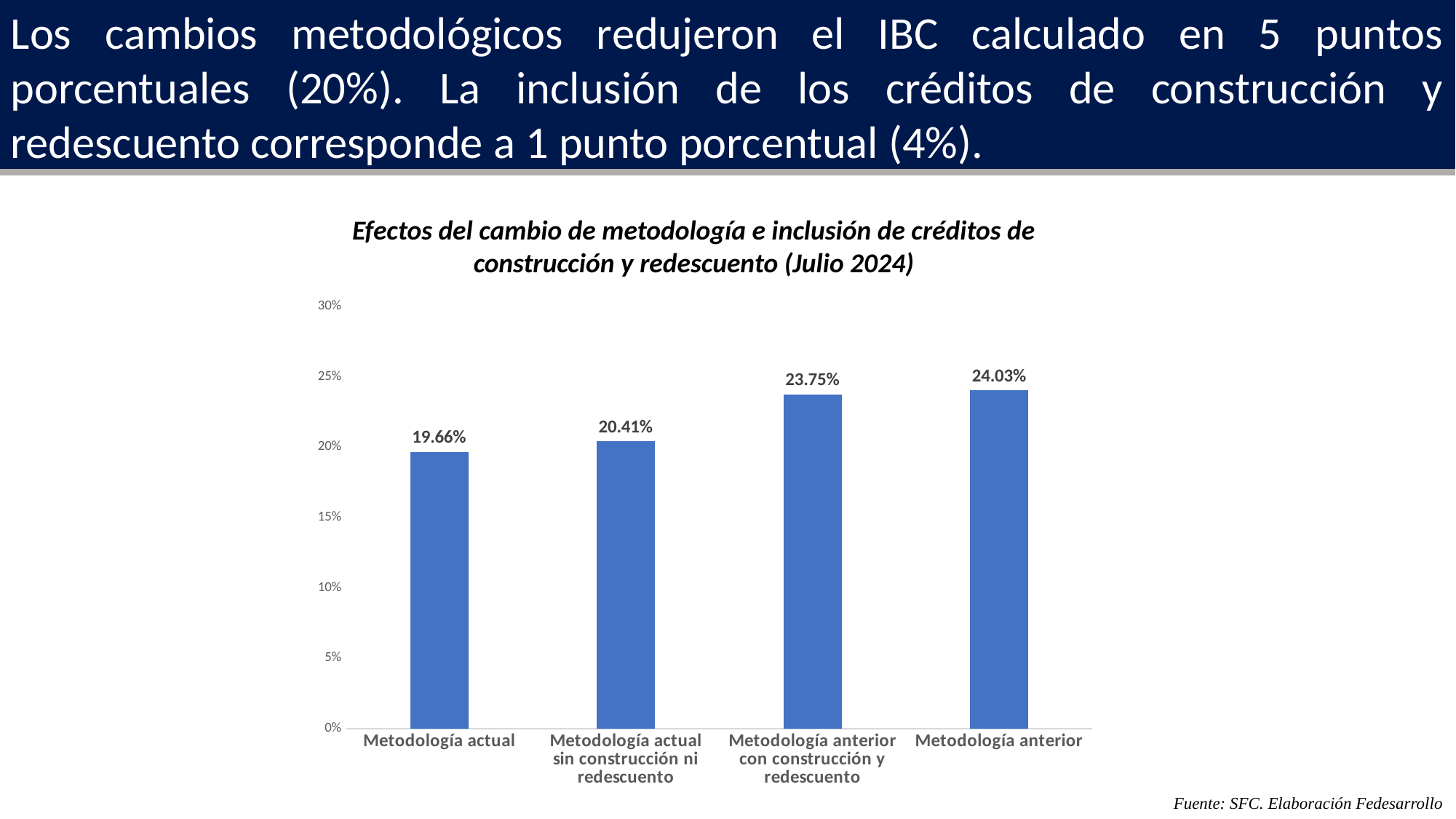
What is the difference between Metodología anterior and Metodología actual? 4.37% How many categories are shown in the chart? 4 What is the value for Metodología anterior? 24.03% Do the values rise or fall from left to right along the x axis? Rise What is the value for Metodología actual sin construcción ni redescuento? 20.41% What kind of chart is shown on the slide? Bar chart What is the difference between Metodología actual sin construcción ni redescuento and Metodología actual? 0.75% Which is larger, Metodología actual sin construcción ni redescuento or Metodología anterior con construcción y redescuento? Metodología anterior con construcción y redescuento What is the value for Metodología anterior con construcción y redescuento? 23.75% What is the value for Metodología actual? 19.66% Which category has the lowest value? Metodología actual Which category has the highest value? Metodología anterior